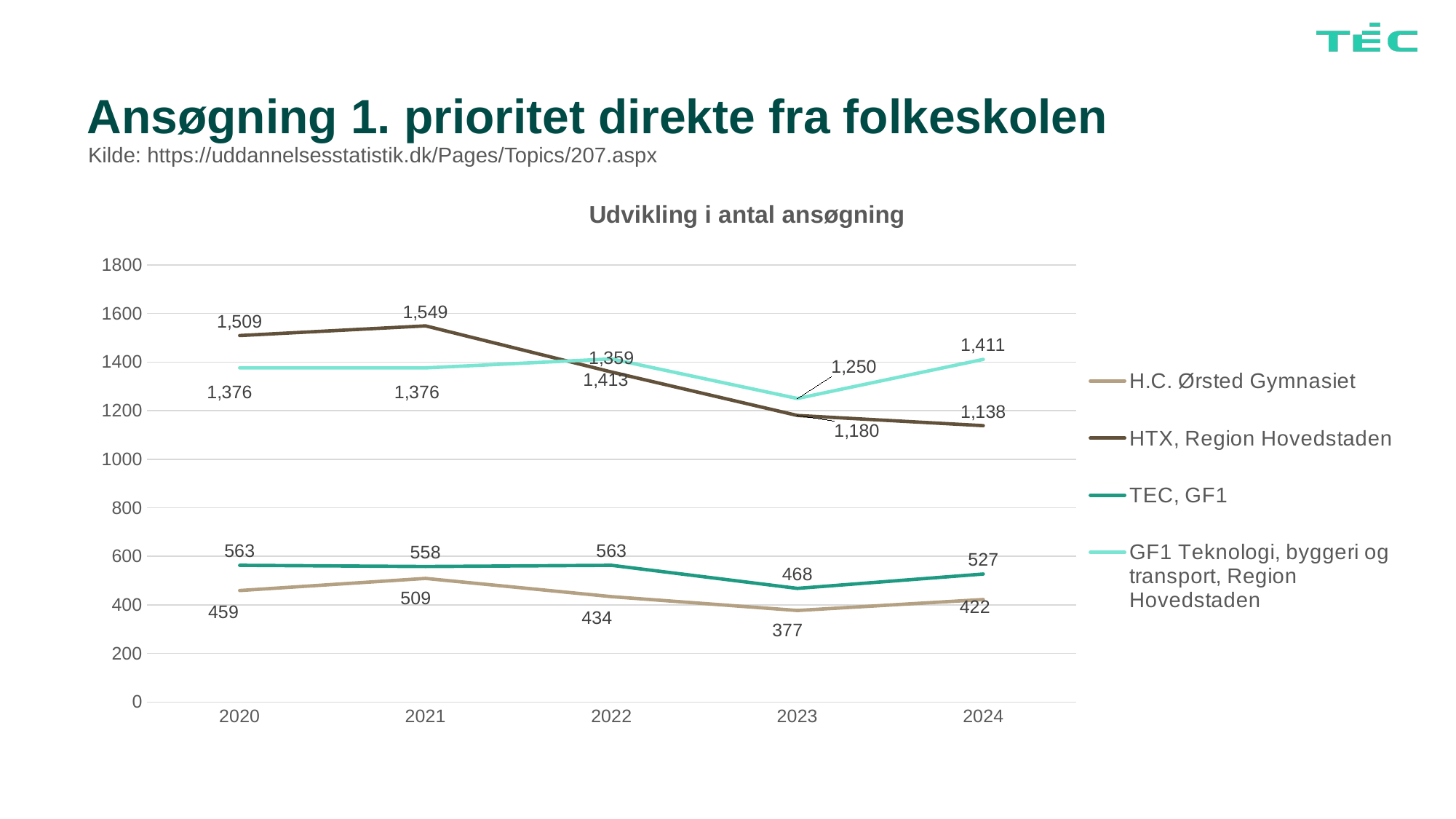
In which year is the value for H.C. Ørsted Gymnasiet lowest? 2023 What kind of chart is shown on the slide? Line chart What is the title of the chart? Udvikling i antal ansøgning By how much did the value for TEC, GF1 increase from 2023 to 2024? 59 In 2024, which is larger: GF1 Teknologi, byggeri og transport, Region Hovedstaden or HTX, Region Hovedstaden? GF1 Teknologi, byggeri og transport, Region Hovedstaden What is the value for H.C. Ørsted Gymnasiet in 2024? 422 How many years are shown on the x axis? 5 Does the value for HTX, Region Hovedstaden rise or fall from 2021 to 2024? Fall In which year is the value for HTX, Region Hovedstaden highest? 2021 What is the value for TEC, GF1 in 2023? 468 What is the value for HTX, Region Hovedstaden in 2021? 1,549 How many series does the legend list? 4